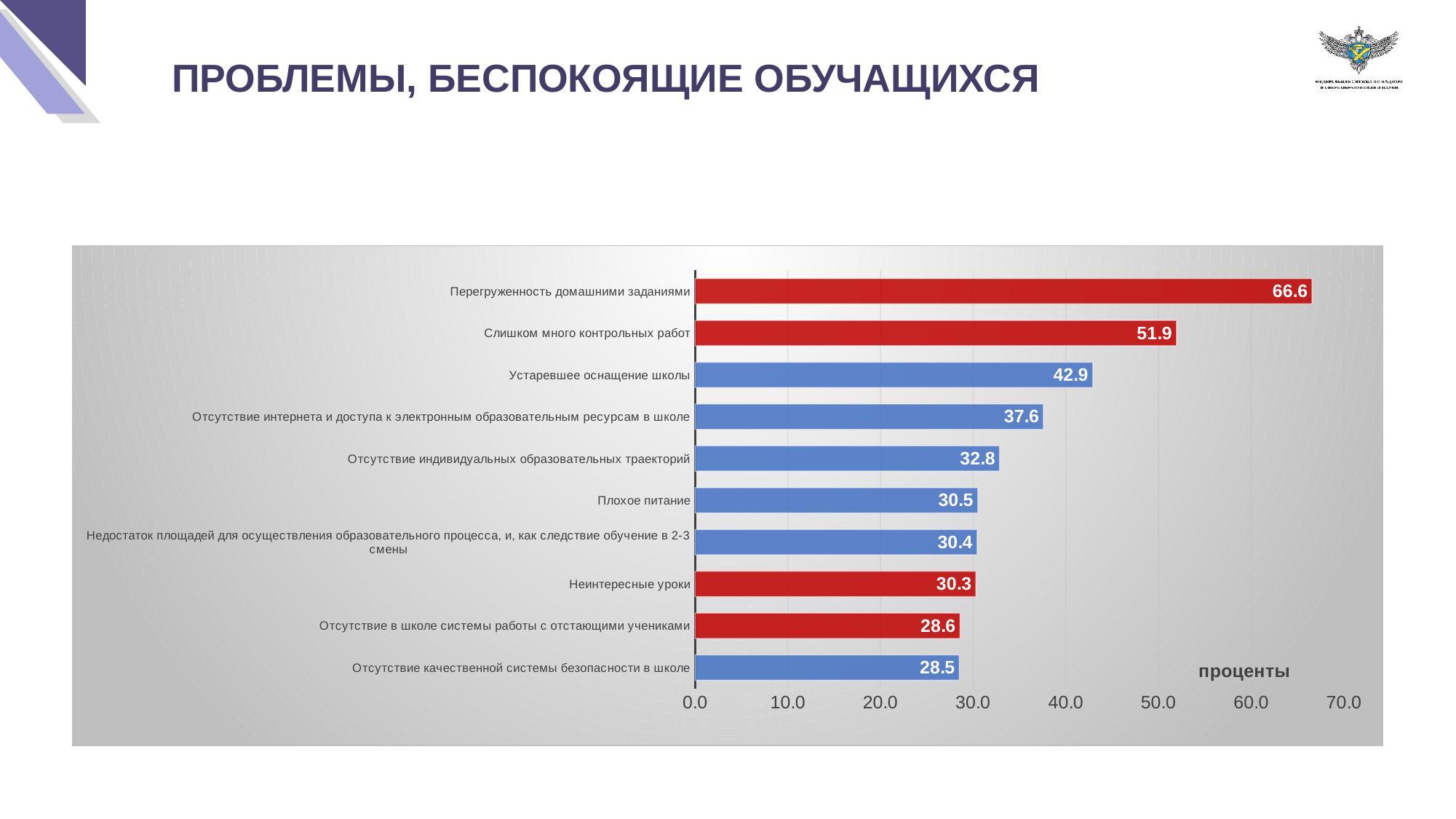
What is the value for «Перегруженность домашними заданиями»? 66.6 What is the title of the slide? ПРОБЛЕМЫ, БЕСПОКОЯЩИЕ ОБУЧАЩИХСЯ What kind of chart is shown on the slide? bar chart What is the difference between «Перегруженность домашними заданиями» and «Слишком много контрольных работ»? 14.7 What is the value for «Плохое питание»? 30.5 What is the value for «Отсутствие в школе системы работы с отстающими учениками»? 28.6 Which is larger: «Устаревшее оснащение школы» or «Отсутствие интернета и доступа к электронным образовательным ресурсам в школе»? Устаревшее оснащение школы Which category has the lowest value? Отсутствие качественной системы безопасности в школе How many categories are shown in the chart? 10 Which category has the highest value? Перегруженность домашними заданиями What is the label on the horizontal axis of the chart? проценты Is the value for «Отсутствие индивидуальных образовательных траекторий» greater or less than 30.0? greater